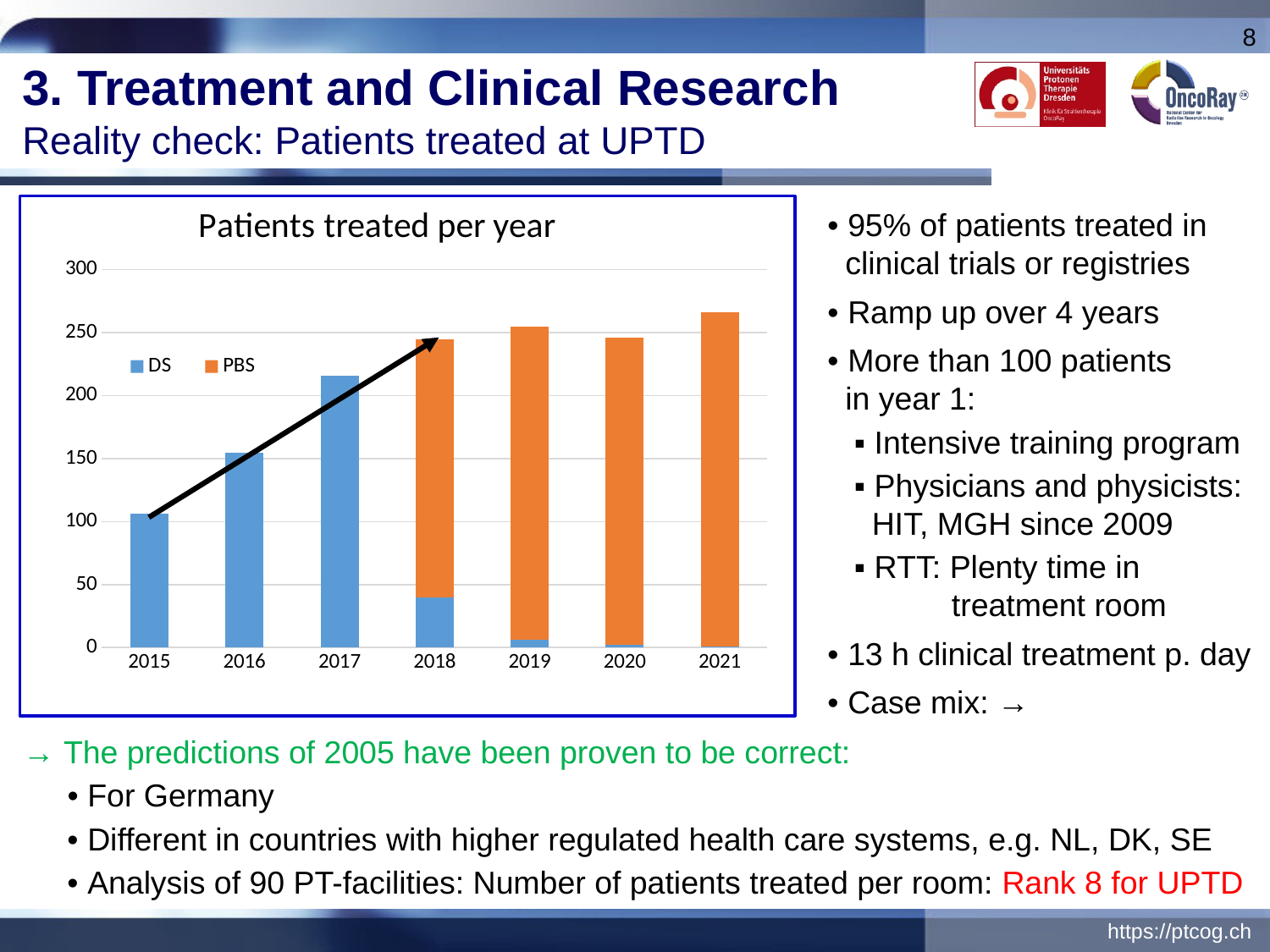
Which year has the lowest total number of patients treated? 2015 Is the total value for 2021 greater or less than 250? greater How many series does the chart legend list? 2 What is the title of the chart? Patients treated per year What kind of chart is shown on the slide? bar chart Is the total value for 2017 greater or less than 200? greater Is the total value for 2015 greater or less than 150? less Which two series are listed in the chart legend? DS and PBS Do the total patients treated per year generally rise or fall from 2015 to 2021? rise Which year has the larger total number of patients treated, 2015 or 2017? 2017 How many years are shown on the x axis of the chart? 7